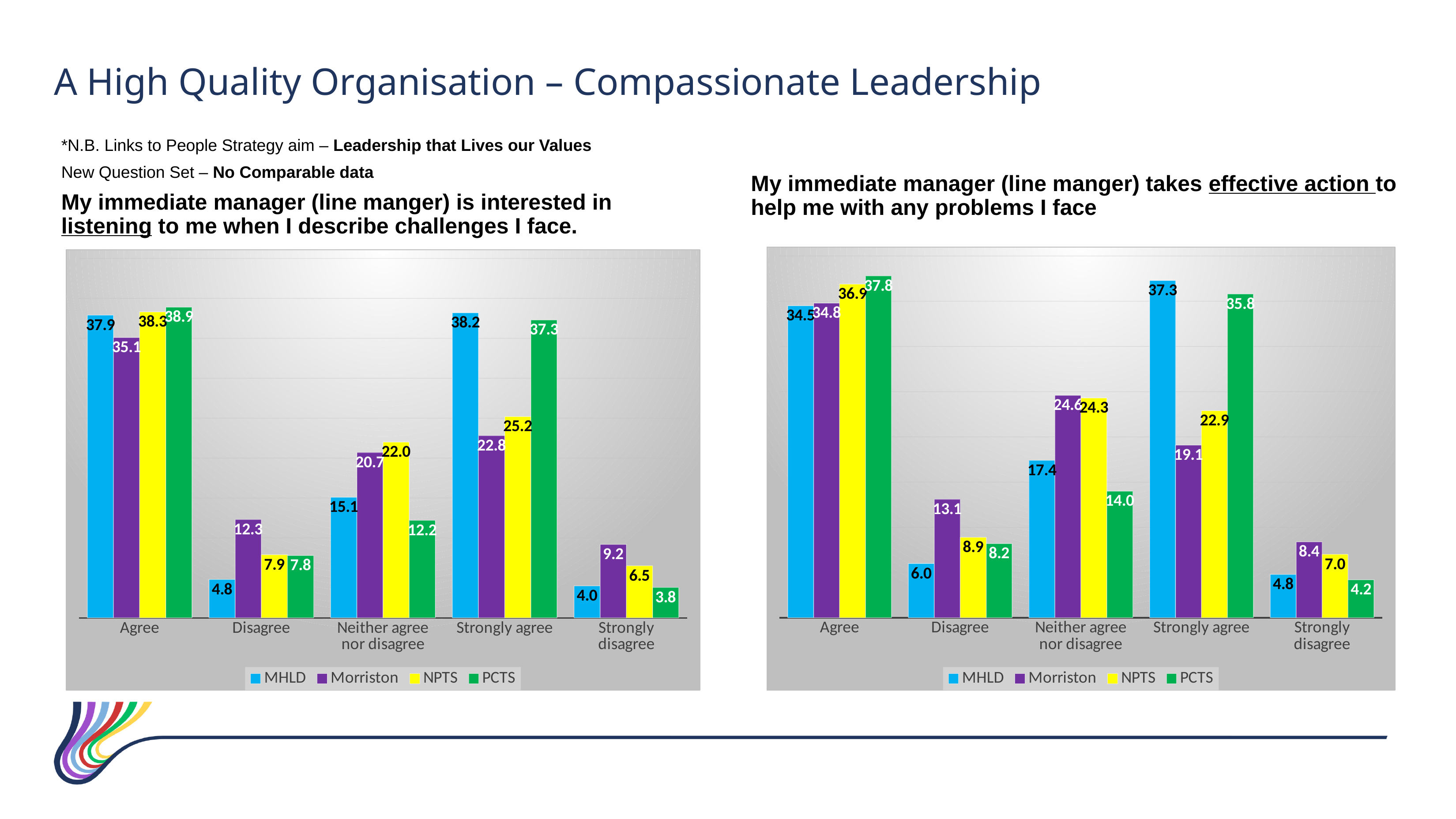
In the left chart (listening), what is the value for Morriston in the Disagree category? 12.3 In the left chart (listening), what is the value for MHLD in the Strongly agree category? 38.2 In the right chart (effective action), what is the value for NPTS in the Neither agree nor disagree category? 24.3 In the right chart (effective action), which is larger in the Agree category: MHLD or PCTS? PCTS In the right chart (effective action), which series has the highest value in the Strongly agree category? MHLD What kind of chart is the left chart (listening)? Bar chart In the right chart (effective action), what is the difference between the Morriston and MHLD values in the Disagree category? 7.1 In the right chart (effective action), what is the value for PCTS in the Strongly agree category? 35.8 In the left chart (listening), what is the difference between the Morriston and MHLD values in the Neither agree nor disagree category? 5.6 How many series does the legend of the right chart (effective action) list? 4 In the left chart (listening), which series has the lowest value in the Strongly disagree category? PCTS How many categories are shown on the x axis of the left chart (listening)? 5